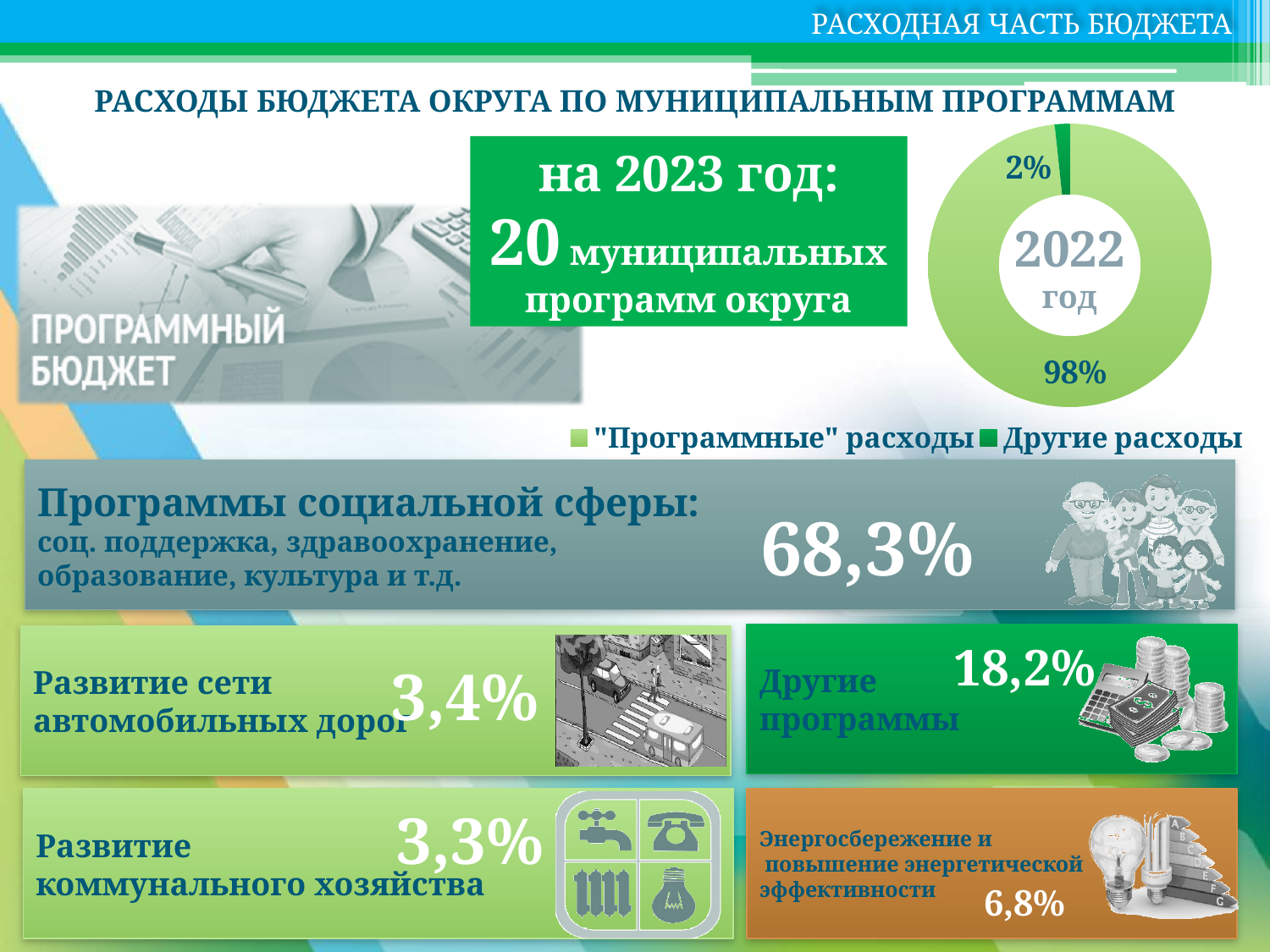
Which is larger in the doughnut chart: "Программные" расходы or Другие расходы? "Программные" расходы What year is written in the centre of the doughnut chart? 2022 год Which category has the largest share in the doughnut chart? "Программные" расходы How many categories does the doughnut chart show? 2 What is the difference in percentage points between "Программные" расходы and Другие расходы in the doughnut chart? 96% Which category has the smallest share in the doughnut chart? Другие расходы What share of the doughnut chart is "Программные" расходы? 98% What kind of chart is shown on the slide? doughnut chart How many entries does the legend of the doughnut chart list? 2 What share of the doughnut chart is Другие расходы? 2% Which legend entry of the doughnut chart is shown in dark green? Другие расходы